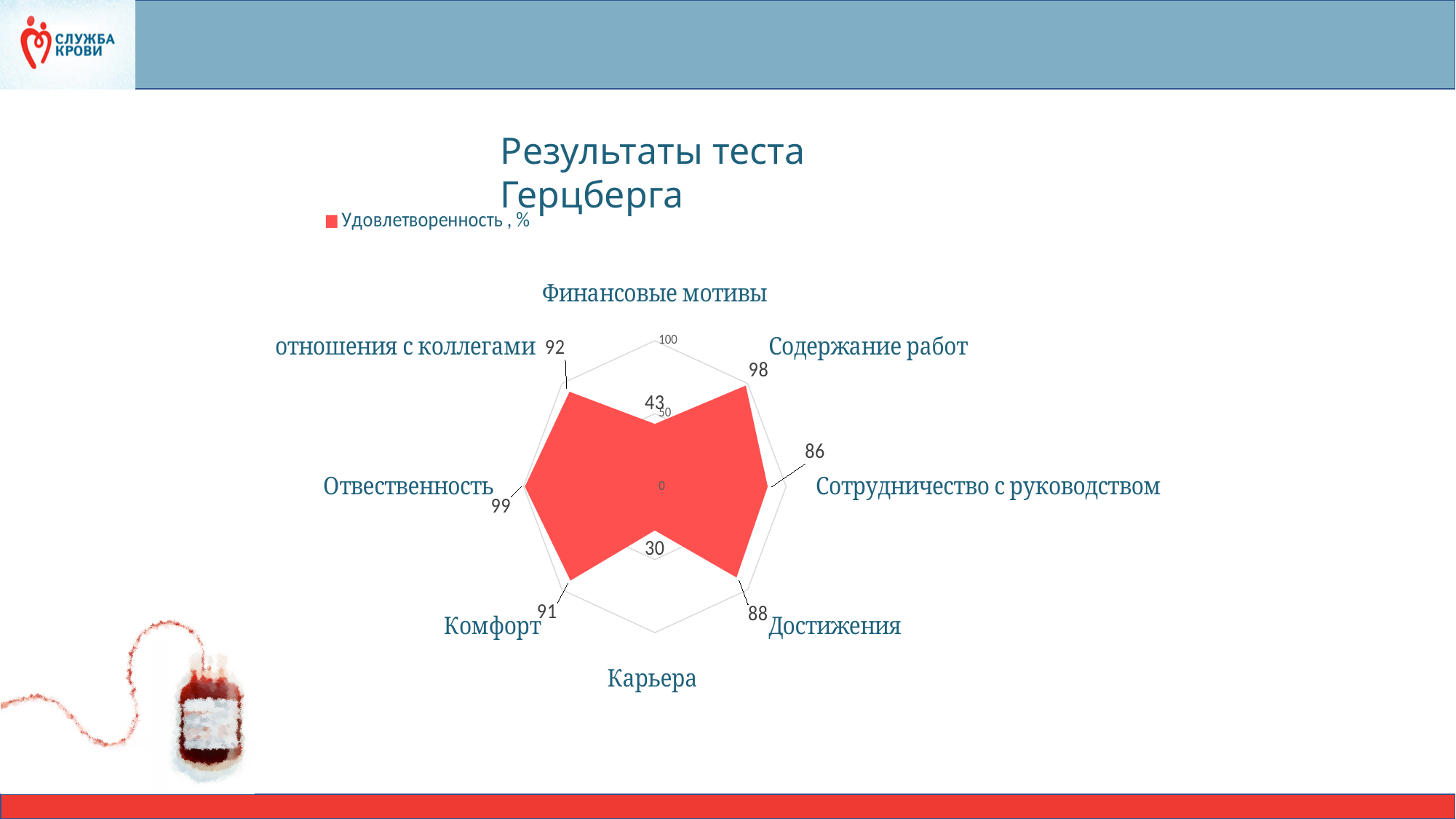
How many categories does the radar chart have? 8 Which is larger, the value for Комфорт or the value for Достижения? Комфорт What is the legend entry of the chart? Удовлетворенность , % What is the value for Финансовые мотивы? 43 What is the value for Сотрудничество с руководством? 86 What is the value for Содержание работ? 98 How many series does the legend list? 1 What is the difference between the values for Ответственность and Карьера? 69 What type of chart is shown on the slide? radar chart Which category has the highest value? Отвественность Which category has the lowest value? Карьера What is the value for Карьера? 30